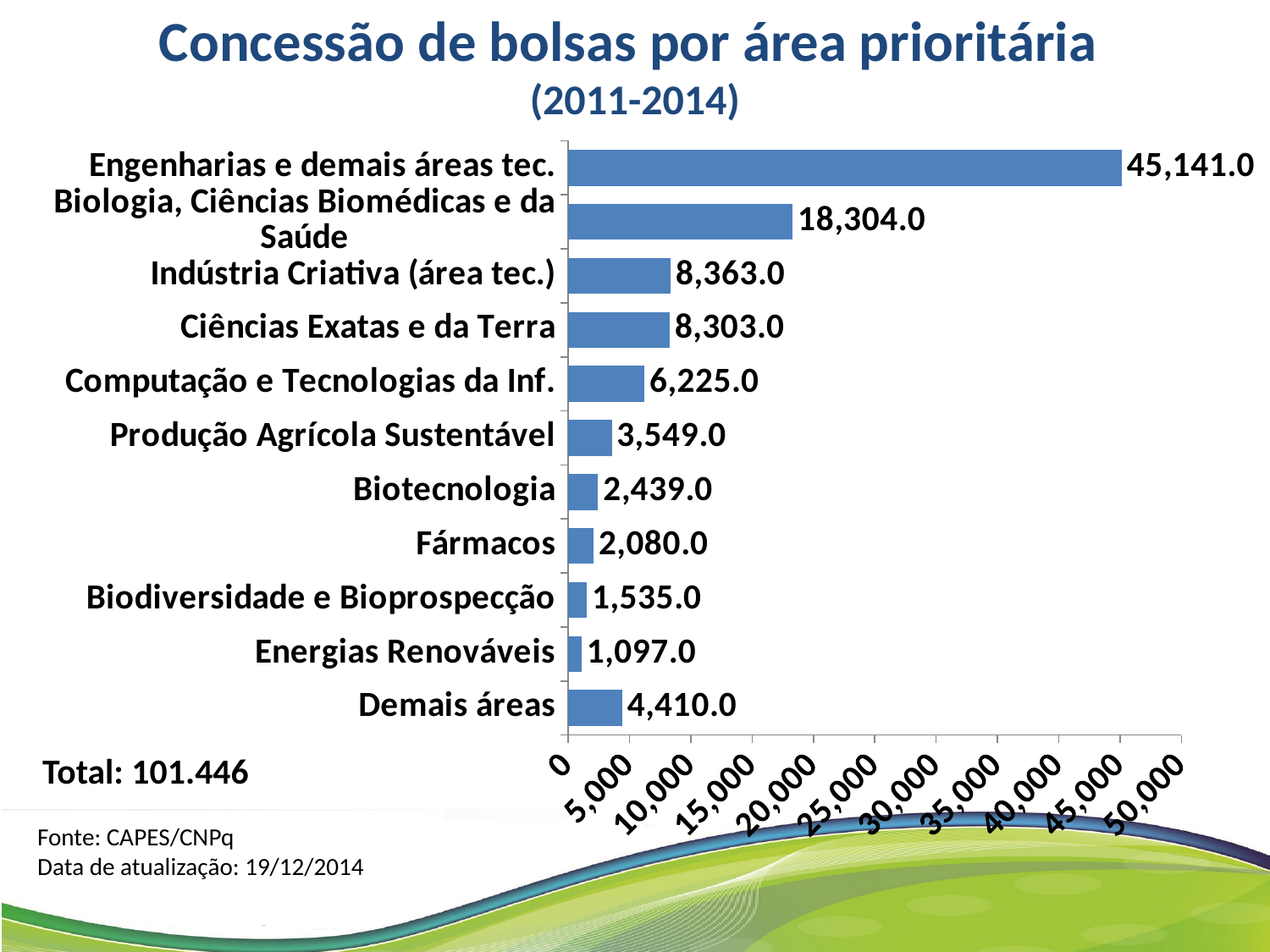
What is the difference between the values for Engenharias e demais áreas tec. and Biologia, Ciências Biomédicas e da Saúde? 26,837.0 What kind of chart is shown on the slide? bar chart Is the value for Demais áreas greater or less than 5,000? less What is the value for Computação e Tecnologias da Inf.? 6,225.0 What is the value for Demais áreas? 4,410.0 What is the value for Biologia, Ciências Biomédicas e da Saúde? 18,304.0 What is the difference between the values for Indústria Criativa (área tec.) and Ciências Exatas e da Terra? 60.0 What is the value for Engenharias e demais áreas tec.? 45,141.0 How many categories are shown in the chart? 11 Which category has the lowest value? Energias Renováveis Which category has the highest value? Engenharias e demais áreas tec. Which is larger, the value for Biotecnologia or the value for Fármacos? Biotecnologia